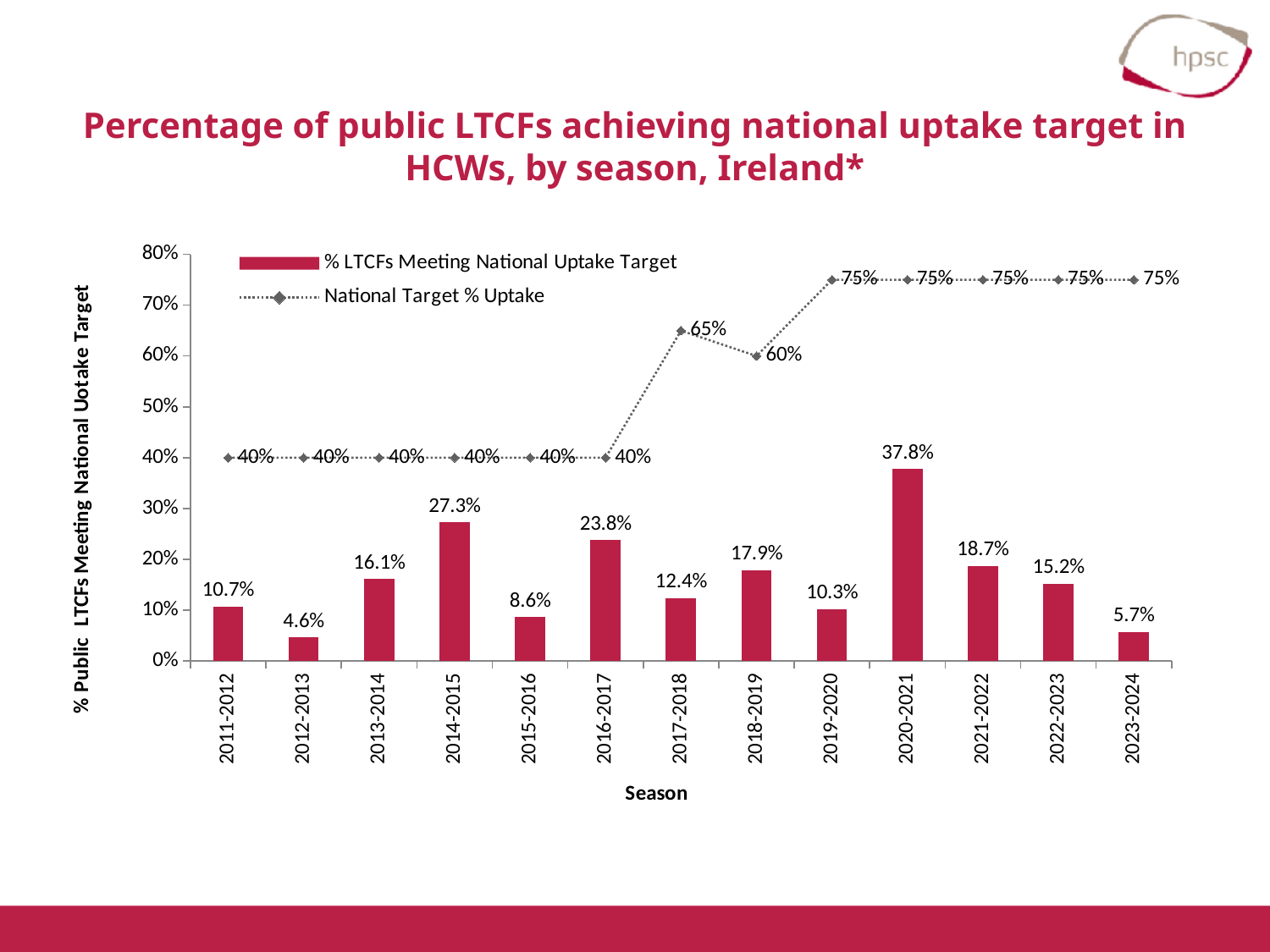
How many seasons are shown on the x axis? 13 What is the label of the x axis? Season Which season had the highest percentage of public LTCFs meeting the national uptake target? 2020-2021 What kind of chart is used to show the % LTCFs Meeting National Uptake Target series? Bar chart Which season had a higher percentage of LTCFs meeting the target, 2016-2017 or 2017-2018? 2016-2017 What is the difference between the percentage of LTCFs meeting the target in 2014-2015 and in 2015-2016? 18.7% What percentage of public LTCFs met the national uptake target in 2023-2024? 5.7% Which season had the lowest percentage of public LTCFs meeting the national uptake target? 2012-2013 What was the national target % uptake for the 2018-2019 season? 60% What percentage of public LTCFs met the national uptake target in the 2020-2021 season? 37.8% How many series does the legend list? 2 In which season did the national target % uptake first reach 75%? 2019-2020